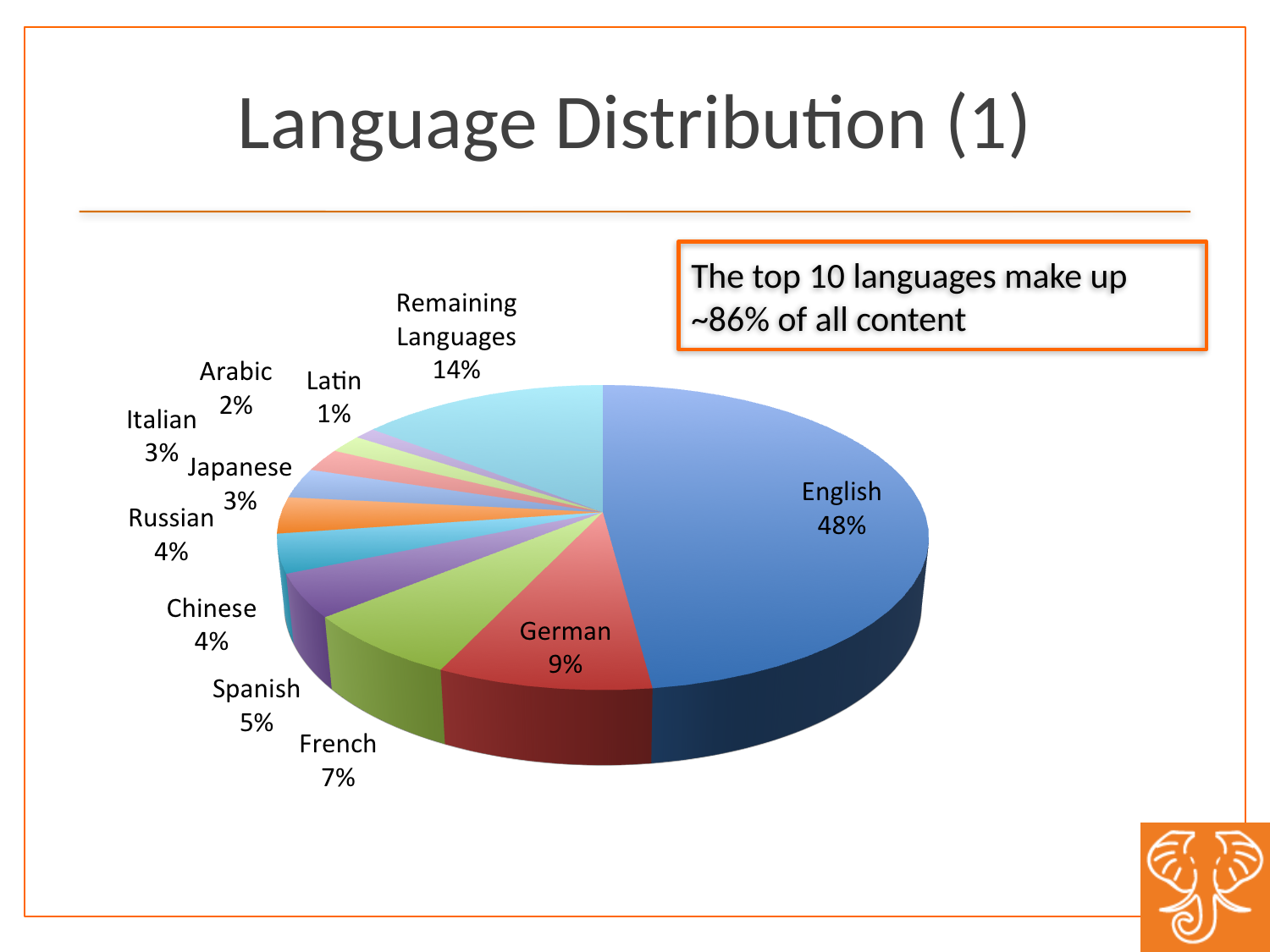
What kind of chart is shown on the slide? Pie chart What percentage is shown for Remaining Languages? 14% What is the difference in percentage points between English and German? 39 Which named language has the smallest slice of the pie? Latin What percentage is shown for German? 9% What percentage is shown for Latin? 1% What share of content is English? 48% How many slices does the pie chart have? 11 What is the title of the slide containing the chart? Language Distribution (1) What is the difference in percentage points between French and Spanish? 2 Which is larger, the share for French or the share for Chinese? French Which language has the largest slice of the pie? English